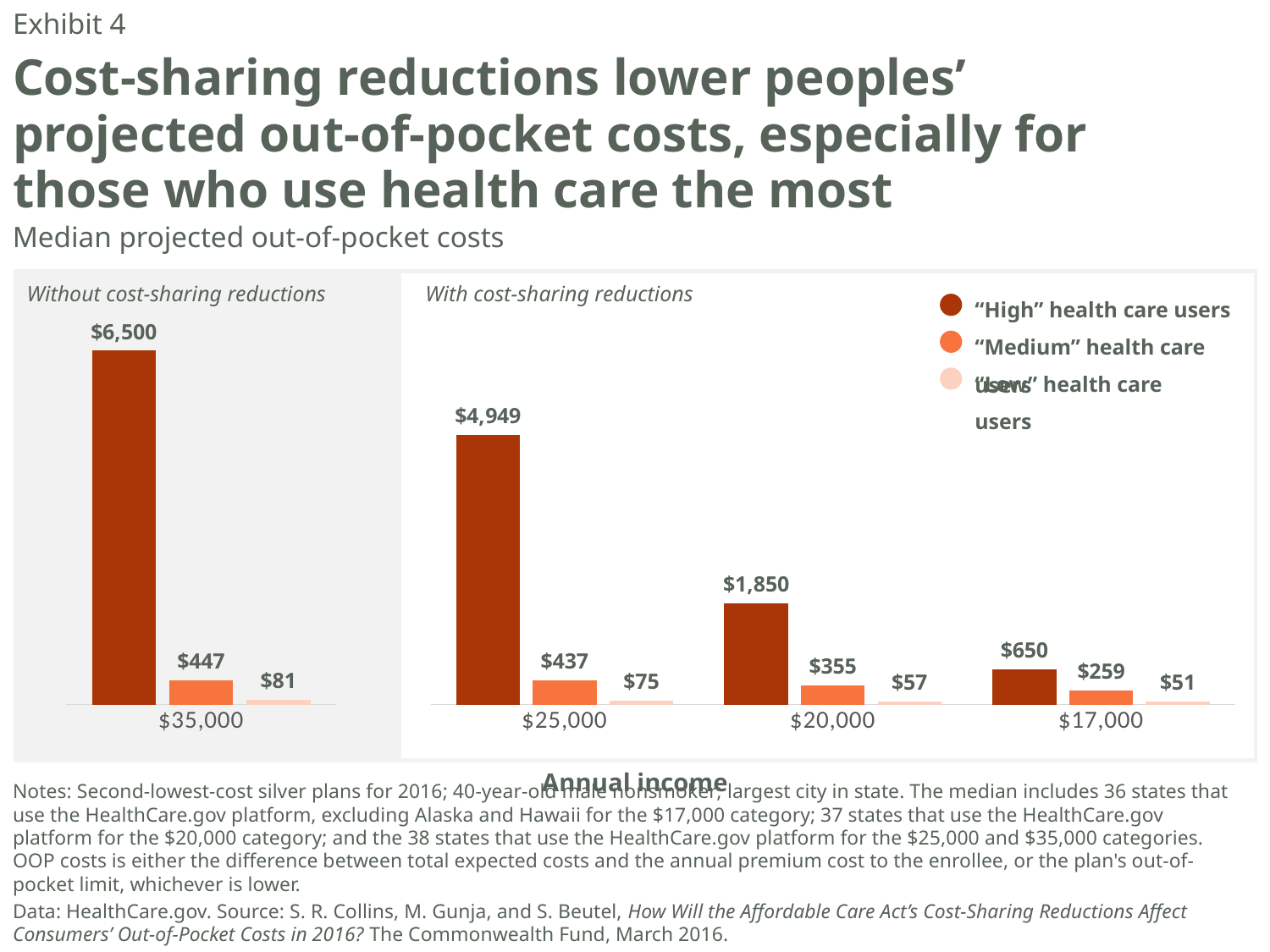
What is the median projected out-of-pocket cost for "High" health care users at an annual income of $35,000? $6,500 What is the median projected out-of-pocket cost for "High" health care users at an annual income of $25,000? $4,949 What is the median projected out-of-pocket cost for "Medium" health care users at an annual income of $20,000? $355 What is the median projected out-of-pocket cost for "Low" health care users at an annual income of $17,000? $51 How many series does the legend list? 3 Which is larger: the out-of-pocket cost for "High" health care users at $20,000 or at $17,000? $20,000 Which annual income category has the lowest out-of-pocket cost for "Low" health care users? $17,000 What is the difference between the out-of-pocket cost for "Medium" health care users at $20,000 and at $17,000? $96 What kind of chart is shown on the slide? Bar chart What is the difference between the out-of-pocket cost for "High" health care users at $35,000 and at $25,000? $1,551 How many annual income categories are shown on the x axis? 4 Which annual income category has the highest out-of-pocket cost for "High" health care users? $35,000